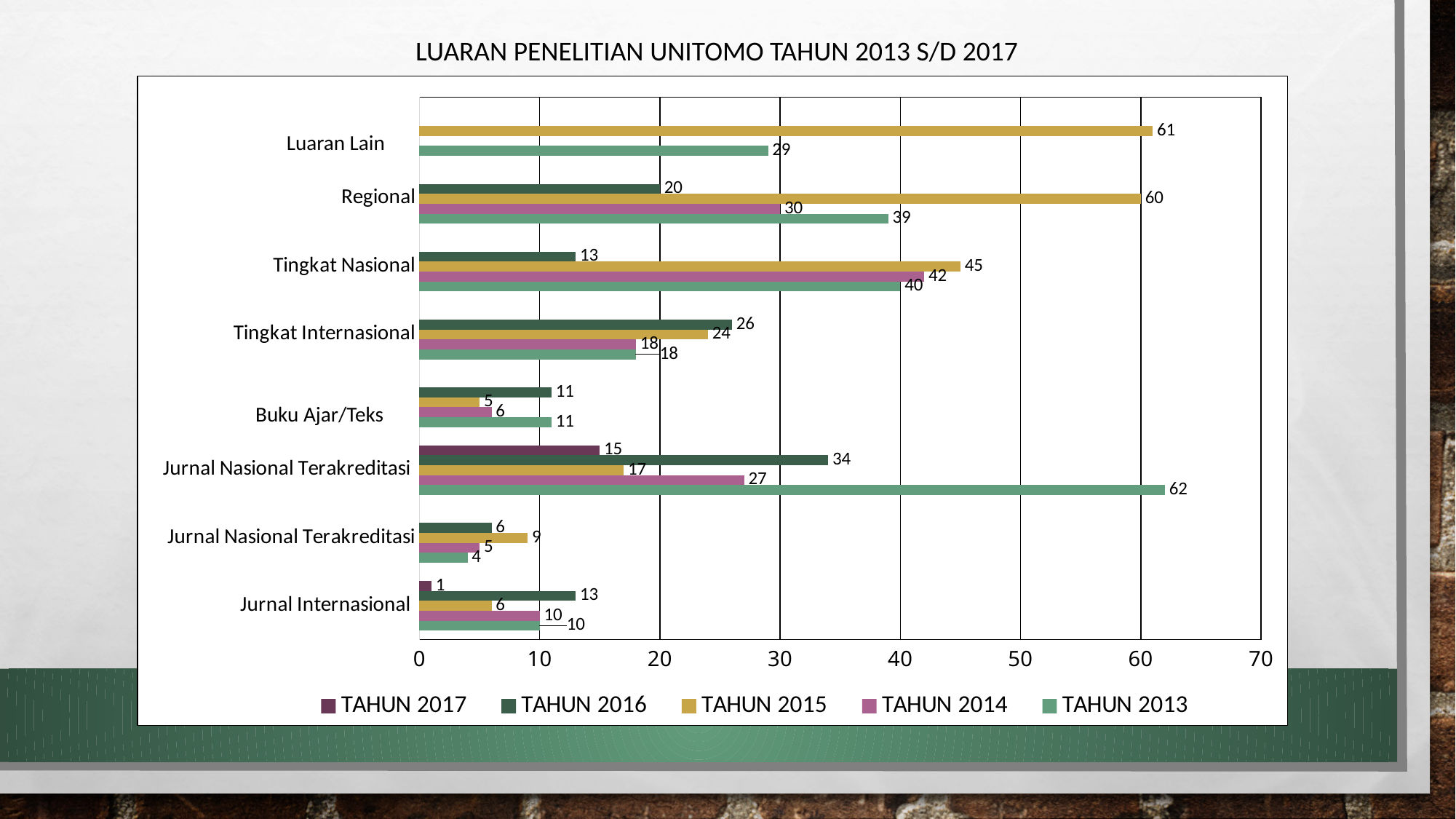
What kind of chart is shown on the slide? bar chart What is the value for TAHUN 2016 in the Tingkat Internasional category? 26 What is the title of the chart? LUARAN PENELITIAN UNITOMO TAHUN 2013 S/D 2017 Which year has the lowest value in the Tingkat Nasional category? TAHUN 2016 What is the value for TAHUN 2017 in the Jurnal Internasional category? 1 Which year has the highest value in the Regional category? TAHUN 2015 How many series does the legend list? 5 In the Buku Ajar/Teks category, which is larger: the TAHUN 2016 value or the TAHUN 2015 value? TAHUN 2016 Is the TAHUN 2015 value for Regional greater or less than 50? greater What is the value for TAHUN 2015 in the Luaran Lain category? 61 What is the value for TAHUN 2013 in the Regional category? 39 What is the difference between the TAHUN 2015 and TAHUN 2013 values in the Luaran Lain category? 32